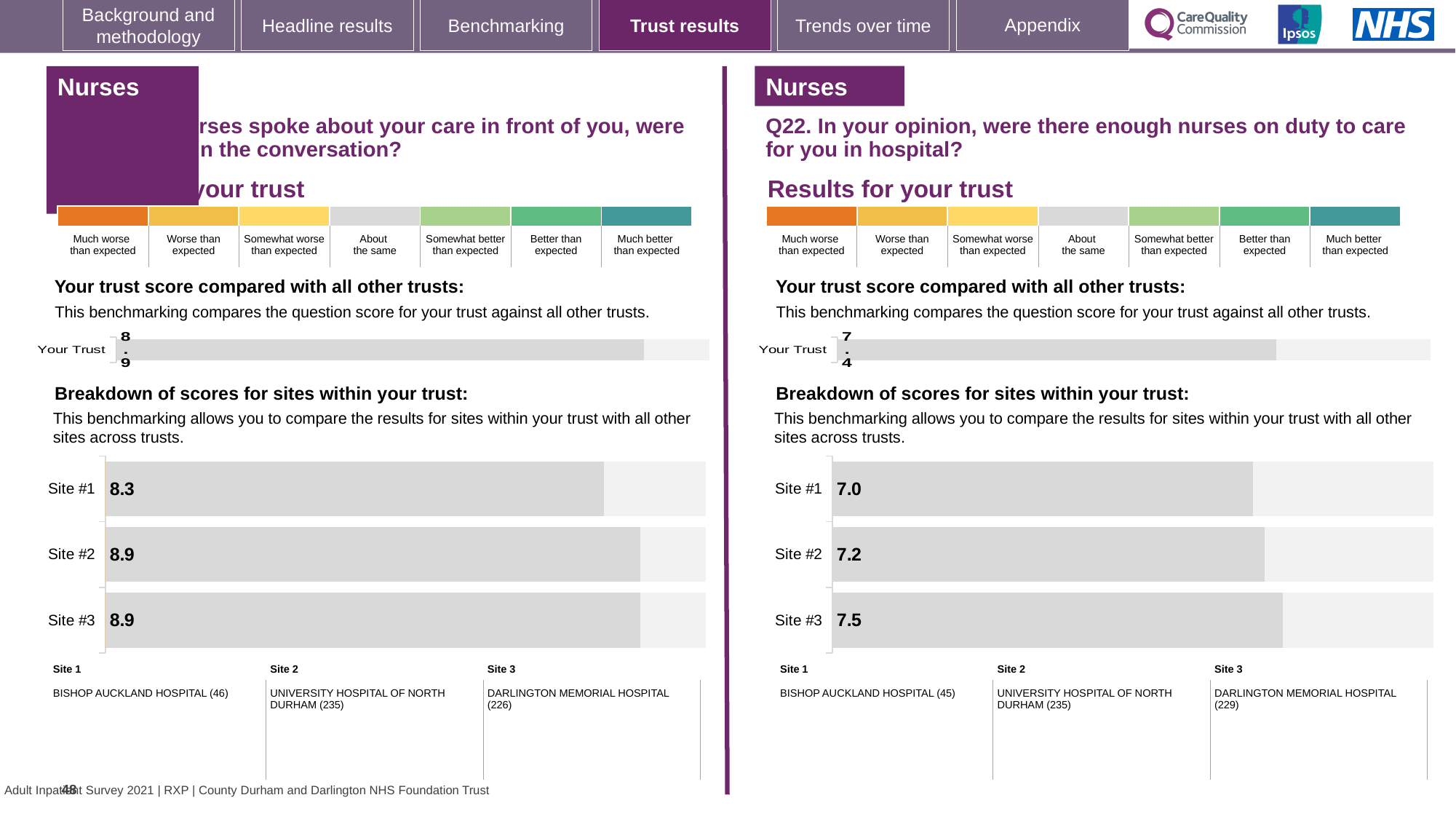
On the left-hand site breakdown chart, which site has the lowest score? Site #1 On the right-hand chart (Q22), what is the difference between the scores for Site #3 and Site #1? 0.5 How many sites are shown in the right-hand site breakdown chart (Q22)? 3 On the right-hand chart (Q22), what is the score for Site #3? 7.5 On the right-hand chart (Q22), which has the larger score, Site #2 or Site #3? Site #3 On the right-hand chart (Q22), what is the score for Site #1? 7.0 On the left-hand site breakdown chart, what is the difference between the scores for Site #2 and Site #1? 0.6 On the right-hand chart (Q22), which site has the lowest score? Site #1 On the right-hand chart (Q22), which site has the highest score? Site #3 On the left-hand site breakdown chart, what is the score for Site #2? 8.9 On the left-hand site breakdown chart, what is the score for Site #1? 8.3 What type of chart is used for the site breakdown on the right-hand side (Q22)? Bar chart